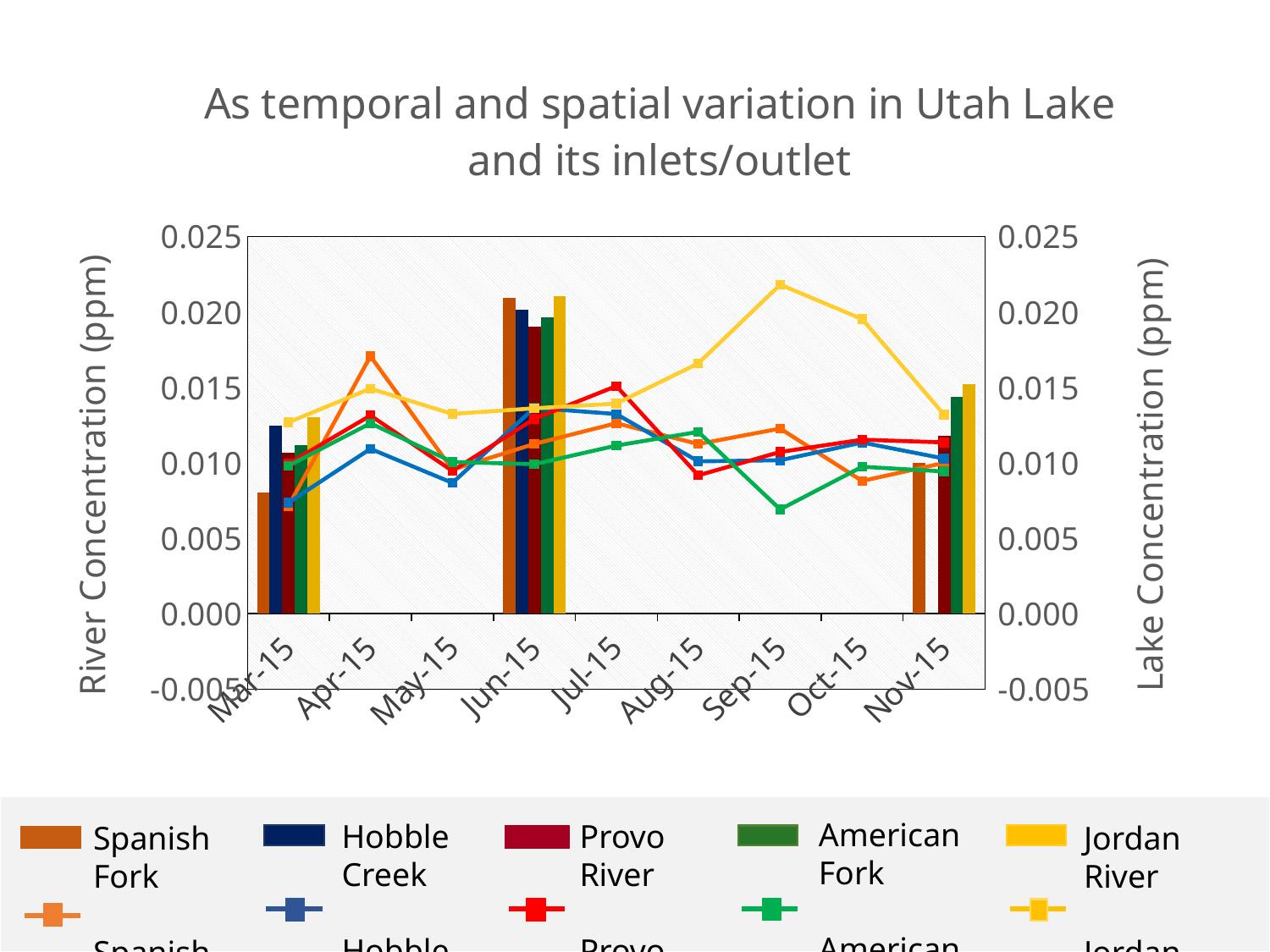
What is the title of the left vertical axis? River Concentration (ppm) What kind of chart is shown on the slide? bar and line chart How many months are shown along the x axis? 9 In how many months are bars plotted? 3 In which month does the American Fork lake concentration line reach its lowest value? Sep-15 Is the Jordan River lake concentration line value for Sep-15 greater or less than 0.020? greater Is the Spanish Fork river concentration bar for Jun-15 greater or less than 0.015? greater Is the Spanish Fork river concentration bar for Mar-15 greater or less than 0.010? less How many bar series does the legend list? 5 In which month does the Jordan River lake concentration line reach its highest value? Sep-15 Does the Jordan River lake concentration line rise or fall from Sep-15 to Nov-15? fall